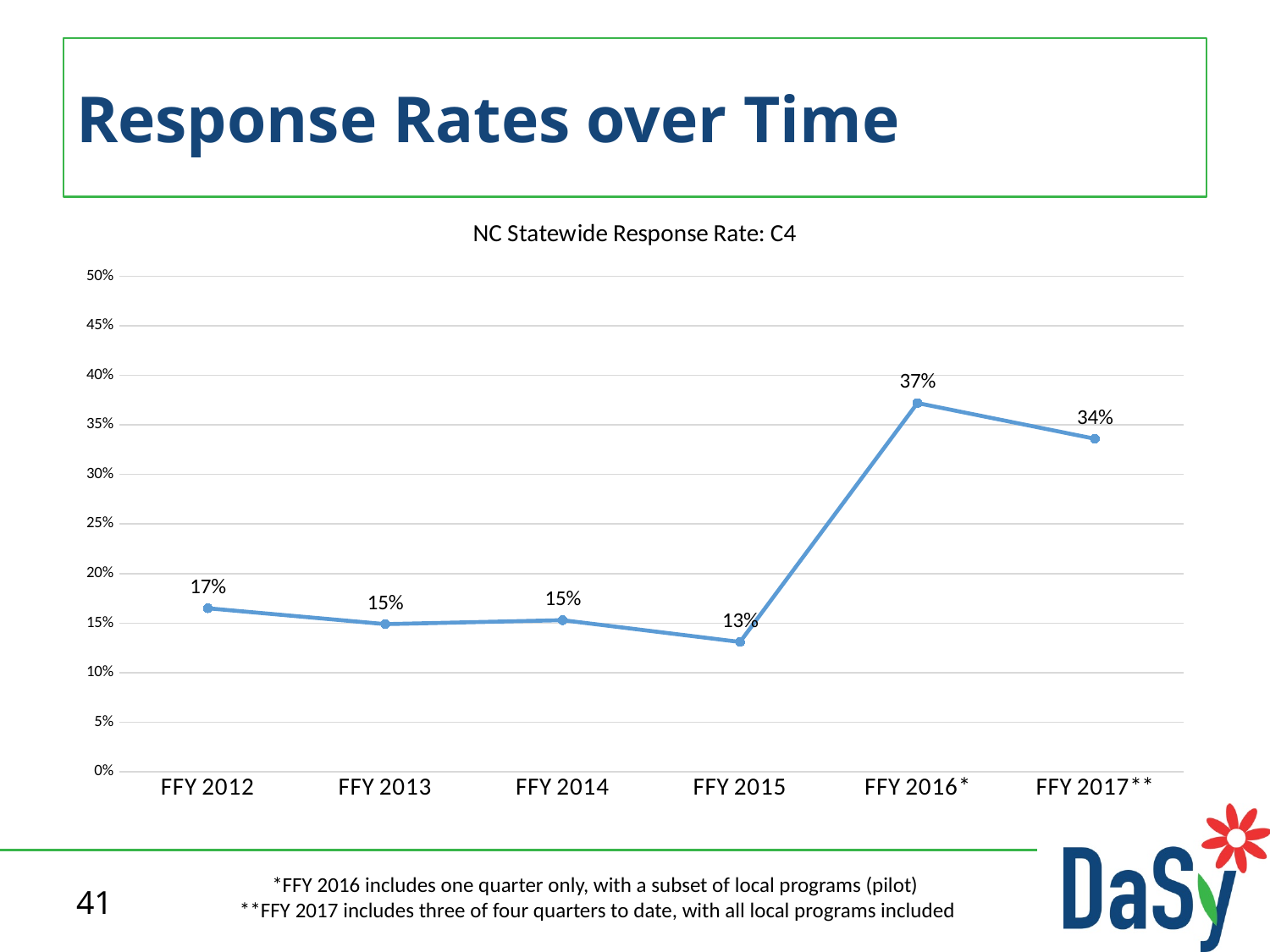
What is the title of the chart? NC Statewide Response Rate: C4 What is the response rate for FFY 2015? 13% What is the response rate for FFY 2012? 17% What is the response rate for FFY 2016*? 37% Is the response rate for FFY 2016* greater or less than 35%? greater What is the response rate for FFY 2017**? 34% Which fiscal year has the highest response rate? FFY 2016* What kind of chart is shown on the slide? Line chart What is the difference between the response rates for FFY 2016* and FFY 2015? 24% How many fiscal years are plotted on the chart? 6 Which is larger, the response rate for FFY 2012 or FFY 2017**? FFY 2017** Which fiscal year has the lowest response rate? FFY 2015